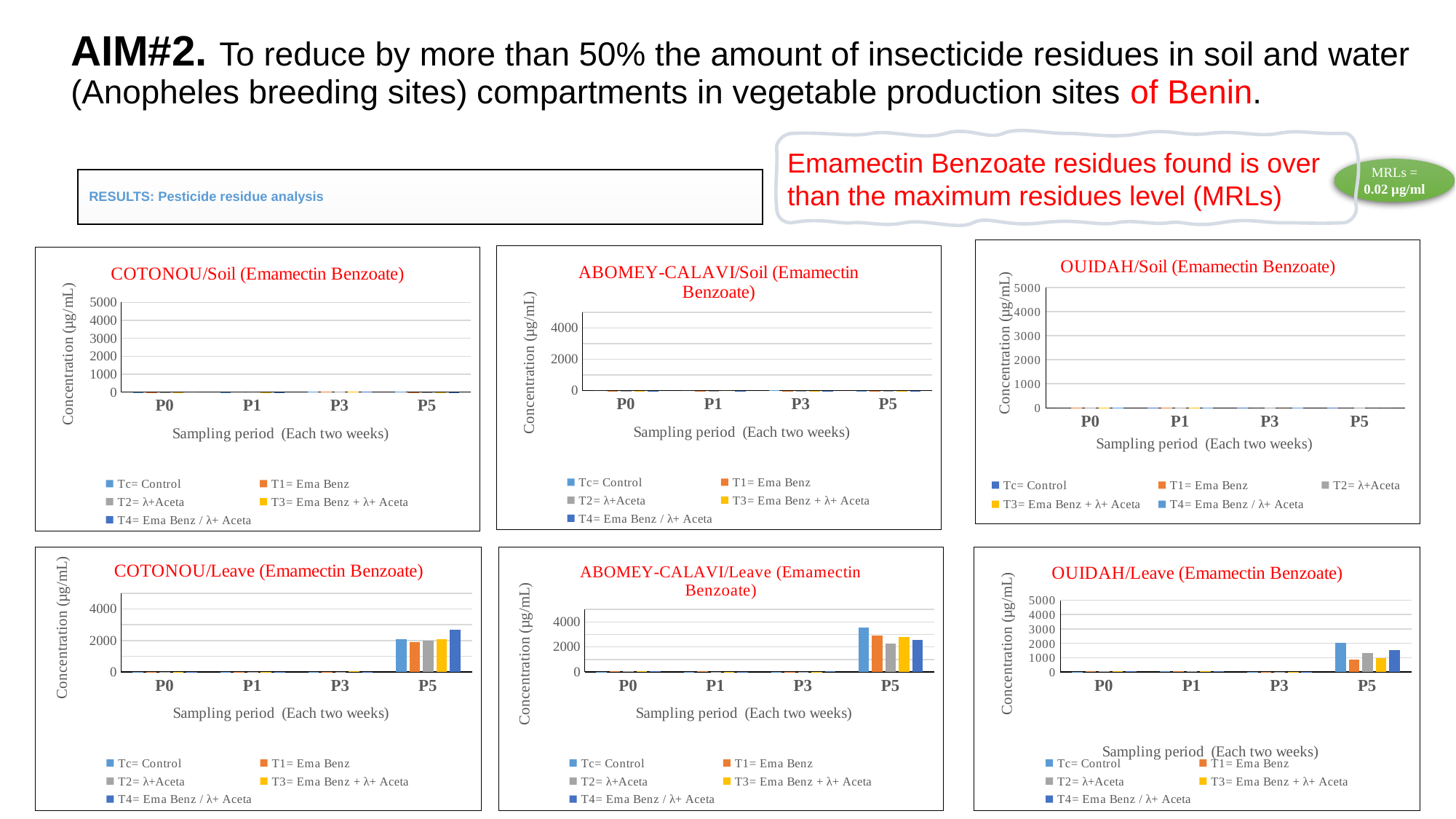
In the ABOMEY-CALAVI/Leave (Emamectin Benzoate) chart, is the value for Tc= Control at P5 greater or less than 4000? less How many series does the legend of the ABOMEY-CALAVI/Leave (Emamectin Benzoate) chart list? 5 In the COTONOU/Leave (Emamectin Benzoate) chart, which series has the highest value at P5? T4= Ema Benz / λ+ Aceta In the COTONOU/Leave (Emamectin Benzoate) chart, do the values rise or fall from P0 to P5? rise What kind of chart is the COTONOU/Leave (Emamectin Benzoate) chart? bar chart What is the x-axis label of the ABOMEY-CALAVI/Soil (Emamectin Benzoate) chart? Sampling period (Each two weeks) In the OUIDAH/Leave (Emamectin Benzoate) chart, is the value for T1= Ema Benz at P5 greater or less than 2000? less In the ABOMEY-CALAVI/Leave (Emamectin Benzoate) chart, which series has the highest value at P5? Tc= Control In the COTONOU/Leave (Emamectin Benzoate) chart, is the value for T4= Ema Benz / λ+ Aceta at P5 greater or less than 2000? greater In the OUIDAH/Leave (Emamectin Benzoate) chart, which is larger at P5: Tc= Control or T1= Ema Benz? Tc= Control How many sampling periods are shown on the x axis of the OUIDAH/Soil (Emamectin Benzoate) chart? 4 In the ABOMEY-CALAVI/Leave (Emamectin Benzoate) chart, which series has the lowest value at P5? T2= λ+Aceta